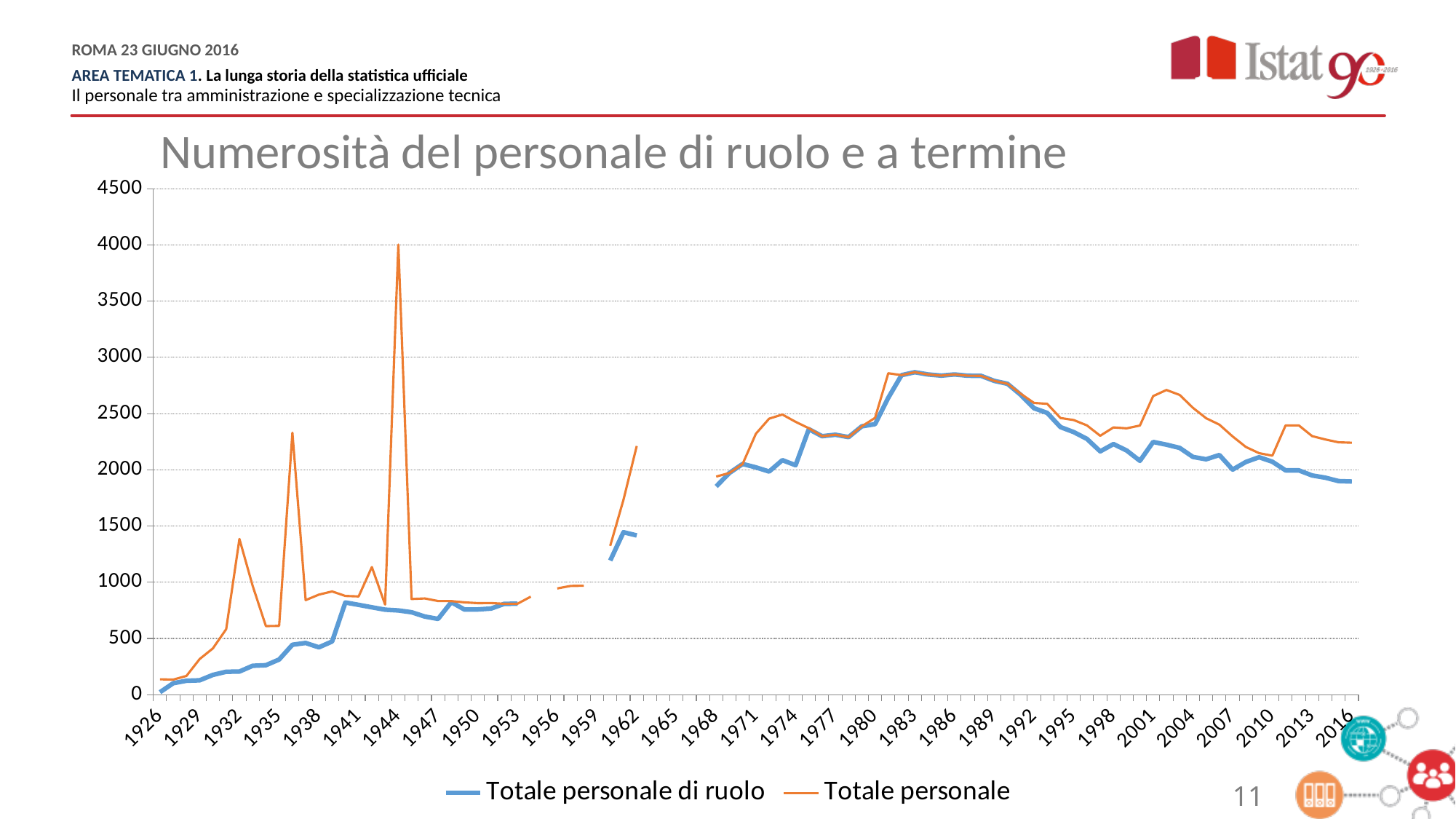
In which year does the 'Totale personale' line reach its highest value? 1944 What is the title of the chart? Numerosità del personale di ruolo e a termine Is the value for 'Totale personale di ruolo' in 1983 greater or less than 2500? greater Is the highest point of the 'Totale personale' line greater or less than 3500? greater From 1926 to 1941, does the 'Totale personale di ruolo' line rise or fall? rise Is the value for 'Totale personale di ruolo' in 2016 greater or less than 2000? less Which colour is used for the 'Totale personale di ruolo' series? blue In 2016, which series has the higher value, 'Totale personale di ruolo' or 'Totale personale'? Totale personale How many series does the legend list? 2 What kind of chart is shown on the slide? line chart From 2010 to 2016, does the 'Totale personale di ruolo' line rise or fall? fall